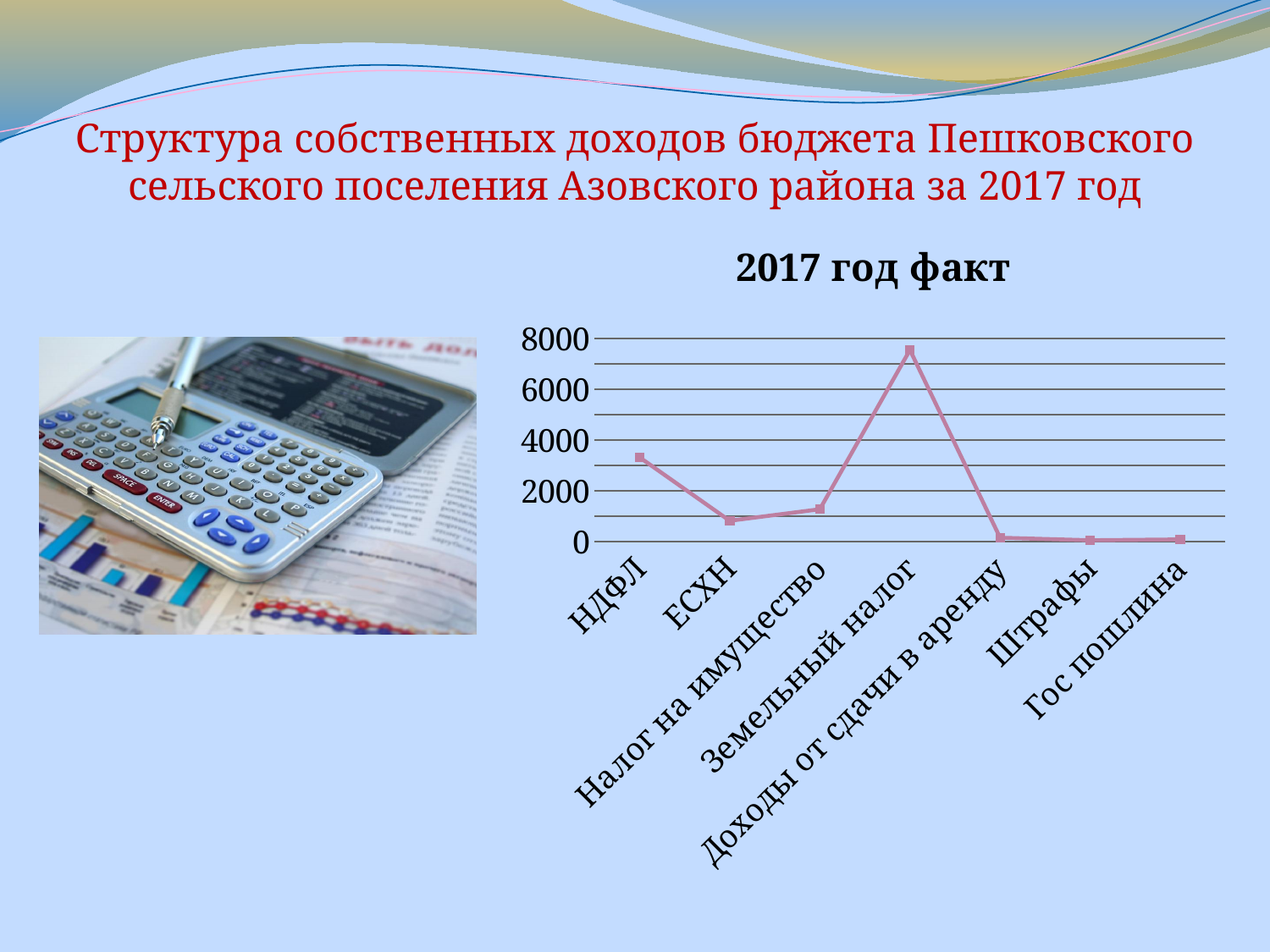
Which category has the highest value in the chart? Земельный налог Is the value for НДФЛ greater or less than 2000? greater Is the value for Налог на имущество greater or less than 2000? less What kind of chart is shown on the slide? line chart How many categories are plotted along the x axis of the chart? 7 What is the title of the chart? 2017 год факт Which is larger, the value for НДФЛ or the value for ЕСХН? НДФЛ Does the line rise or fall from Земельный налог to Доходы от сдачи в аренду? fall Is the value for НДФЛ greater or less than 4000? less Does the line rise or fall from Налог на имущество to Земельный налог? rise